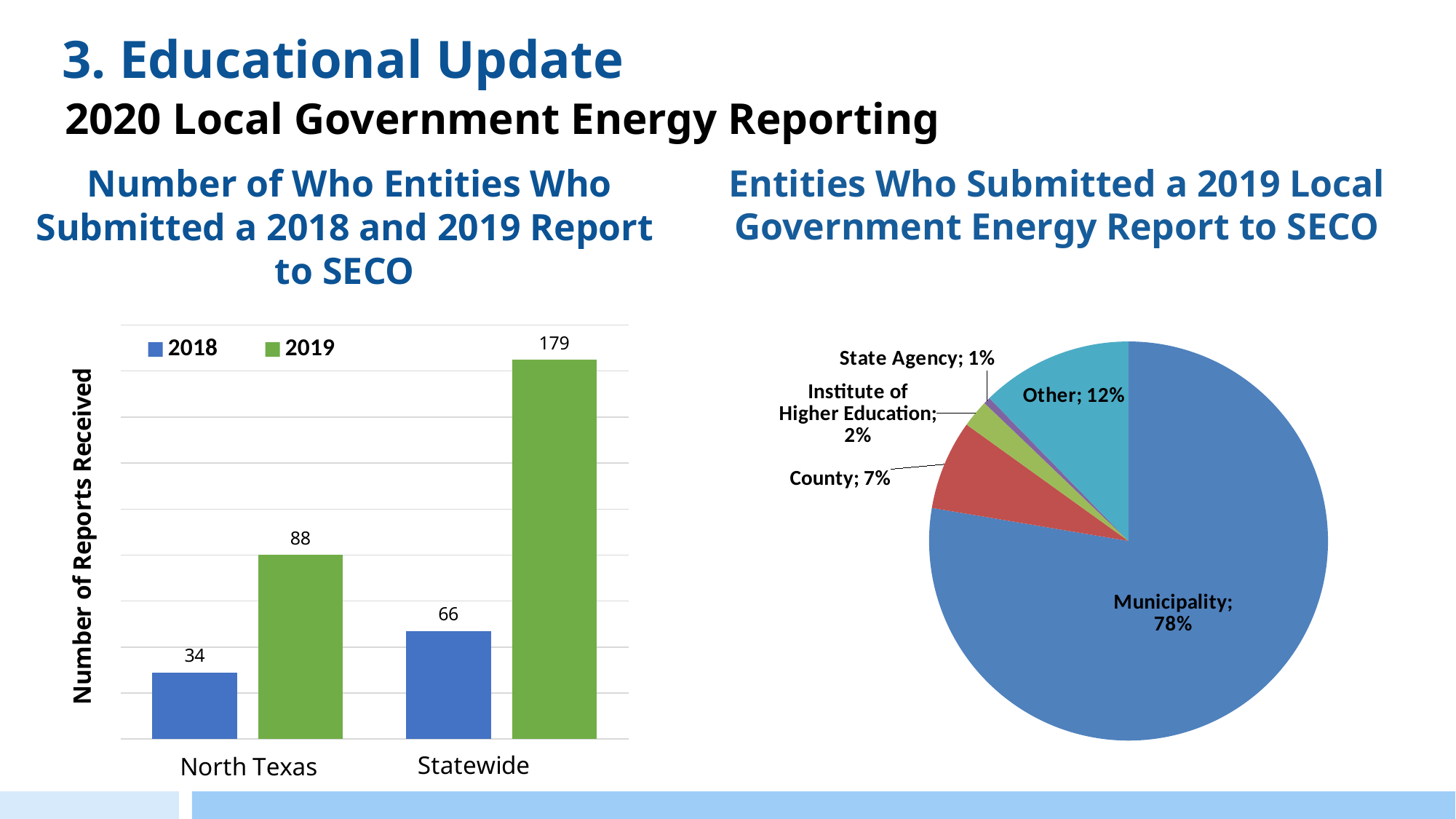
In the bar chart on the left, what is the difference between the Statewide 2019 and 2018 values? 113 In the bar chart on the left, what is the y-axis label? Number of Reports Received In the pie chart on the right, how many slices are there? 5 In the bar chart on the left, which bar is the lowest? North Texas 2018 In the bar chart on the left, how many reports were received Statewide in 2018? 66 In the bar chart on the left, which bar is the tallest? Statewide 2019 In the pie chart on the right, which category has the smallest share? State Agency In the bar chart on the left, how many reports were received from North Texas in 2019? 88 In the bar chart on the left, is the North Texas 2019 value larger or smaller than the Statewide 2018 value? larger In the pie chart on the right, what share of entities are Counties? 7% In the pie chart on the right, what share of entities are Municipalities? 78% In the bar chart on the left, how many series does the legend list? 2